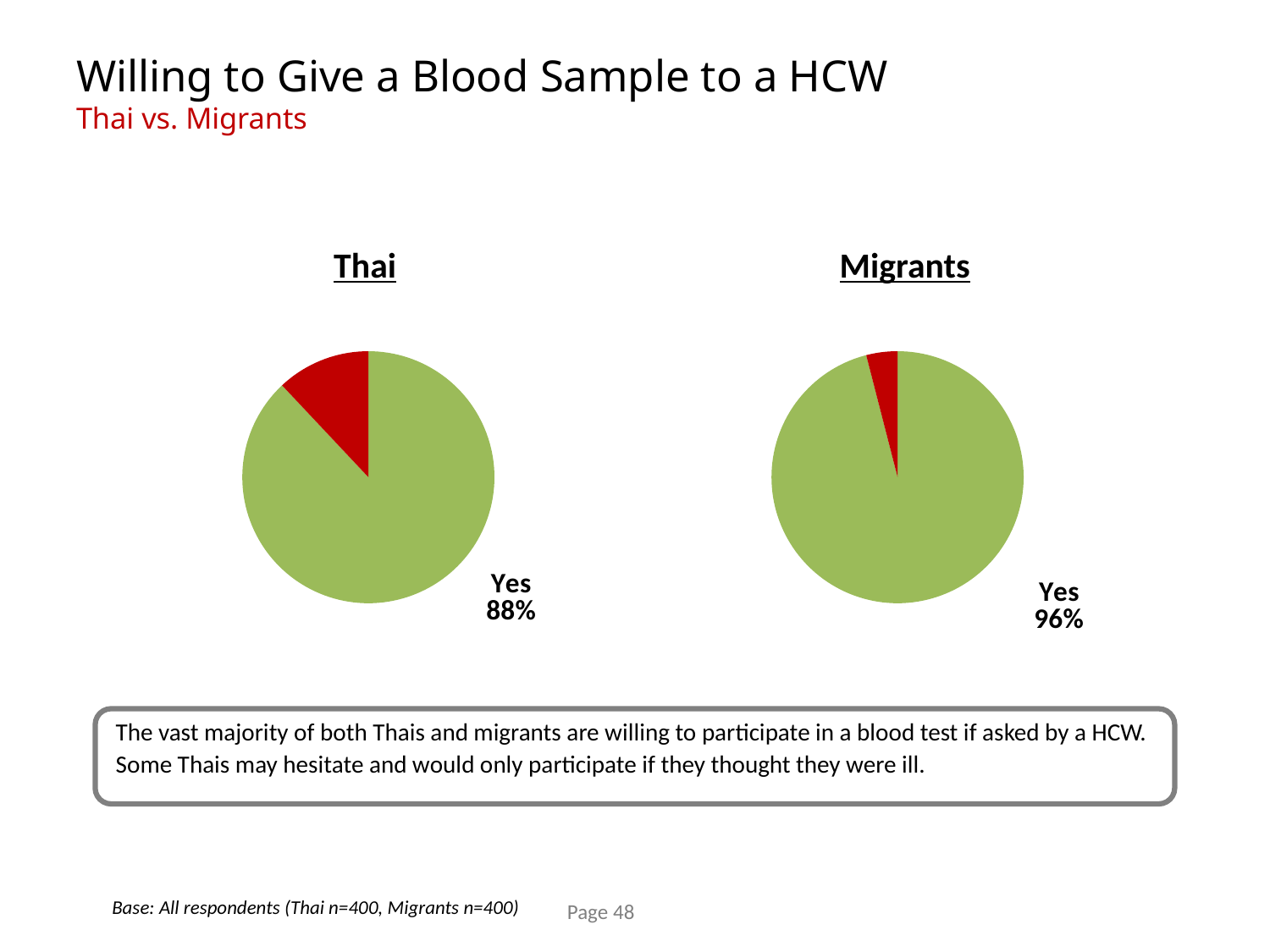
How many pie charts are shown on the slide? 2 Which pie chart has the larger red slice, Thai or Migrants? Thai What is the title of the slide containing the two pie charts? Willing to Give a Blood Sample to a HCW What kind of chart is used to show the Thai and Migrants results? Pie chart In the Migrants pie chart, what share of respondents answered Yes? 96% In the Thai pie chart, what share of respondents answered Yes? 88% What colour is the Yes slice in both pie charts? Green In the Thai pie chart, what share of the pie does the Yes slice take up? 88% In the Migrants pie chart, what share of the pie does the Yes slice take up? 96% How many slices does the Thai pie chart have? 2 Which group has the larger Yes share, Thai or Migrants? Migrants What is the difference in percentage points between the Migrants Yes share and the Thai Yes share? 8 percentage points